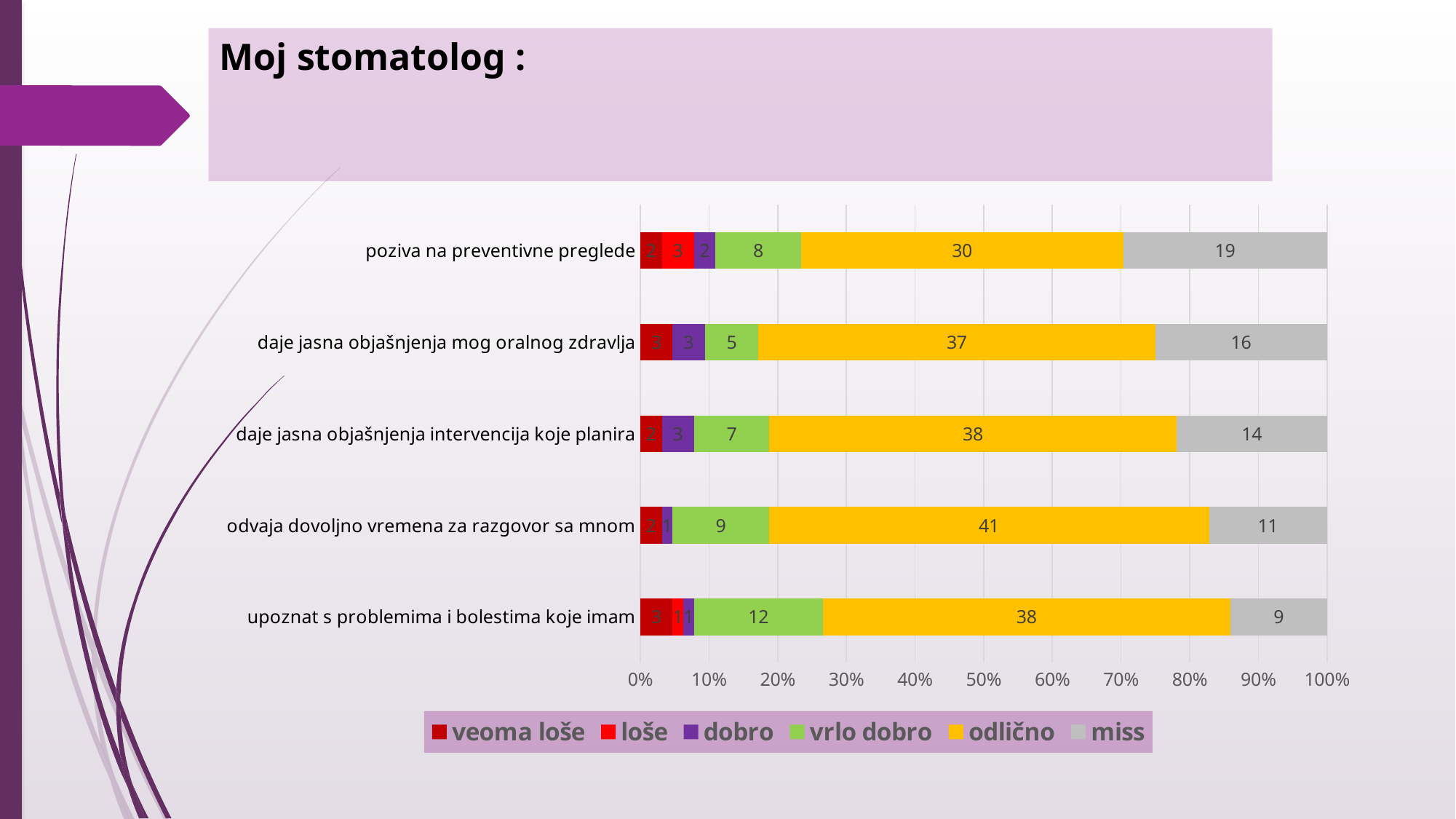
What is the value of the dobro segment for 'daje jasna objašnjenja mog oralnog zdravlja'? 3 Which category has the lowest miss value? upoznat s problemima i bolestima koje imam What is the value of the odlično segment for 'odvaja dovoljno vremena za razgovor sa mnom'? 41 What kind of chart is shown on the slide? stacked bar chart Which category has the highest vrlo dobro value? upoznat s problemima i bolestima koje imam What is the value of the vrlo dobro segment for 'upoznat s problemima i bolestima koje imam'? 12 What is the value of the miss segment for 'poziva na preventivne preglede'? 19 Which category has the highest odlično value? odvaja dovoljno vremena za razgovor sa mnom How many categories are shown on the chart? 5 What is the difference between the miss value for 'poziva na preventivne preglede' and the miss value for 'odvaja dovoljno vremena za razgovor sa mnom'? 8 How many series does the legend list? 6 Which has the larger vrlo dobro value: 'poziva na preventivne preglede' or 'daje jasna objašnjenja intervencija koje planira'? poziva na preventivne preglede